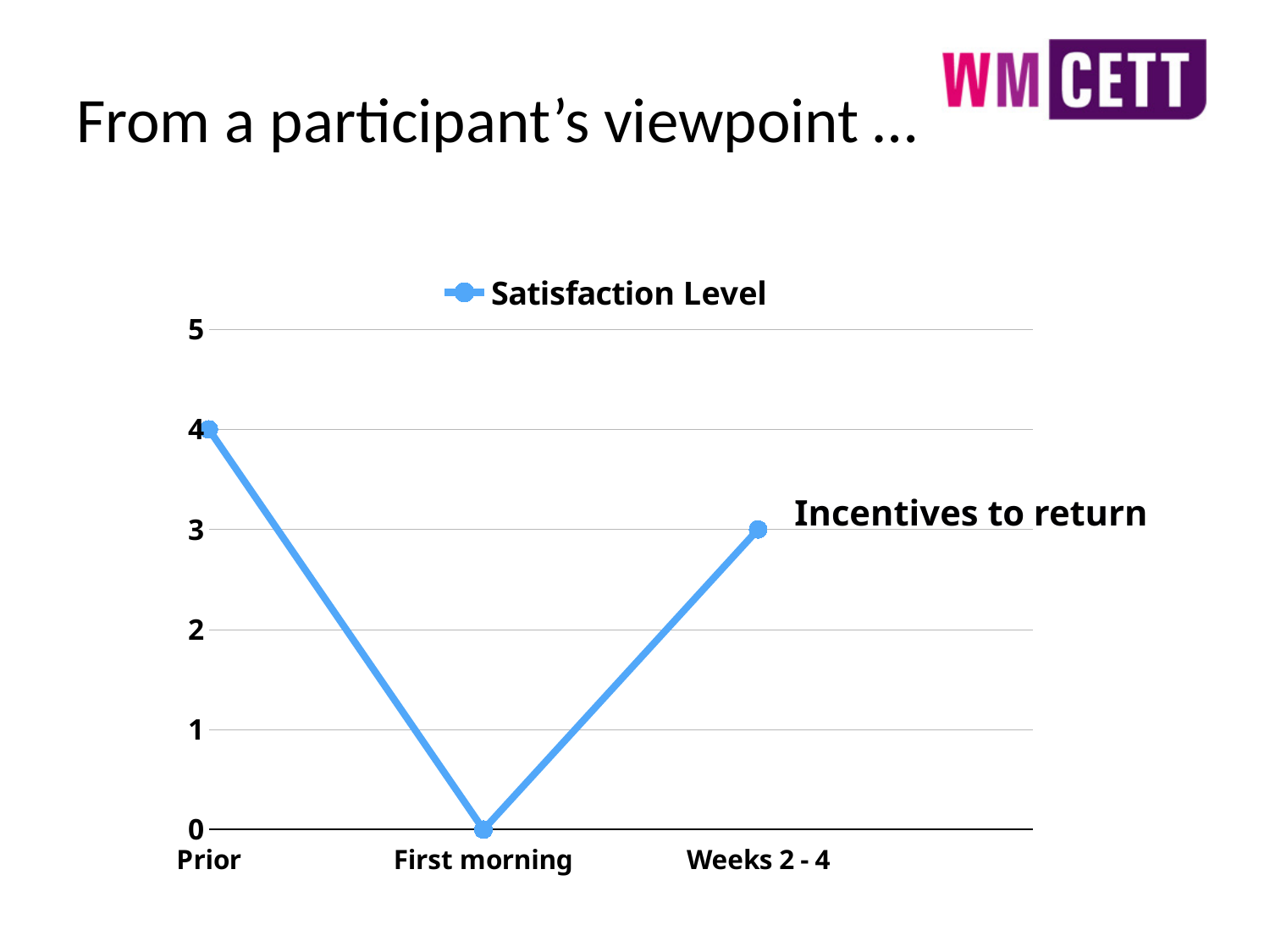
What is the Satisfaction Level for First morning? 0 What is the name of the series shown in the legend? Satisfaction Level Which category has the lowest Satisfaction Level? First morning What is the Satisfaction Level for Prior? 4 Which category has the highest Satisfaction Level? Prior Which has a higher Satisfaction Level, Prior or Weeks 2 - 4? Prior What is the Satisfaction Level for Weeks 2 - 4? 3 How many categories are shown on the x axis? 3 What is the difference in Satisfaction Level between Prior and Weeks 2 - 4? 1 How many series does the legend list? 1 Does the Satisfaction Level rise or fall from Prior to First morning? Fall What kind of chart is shown on the slide? Line chart